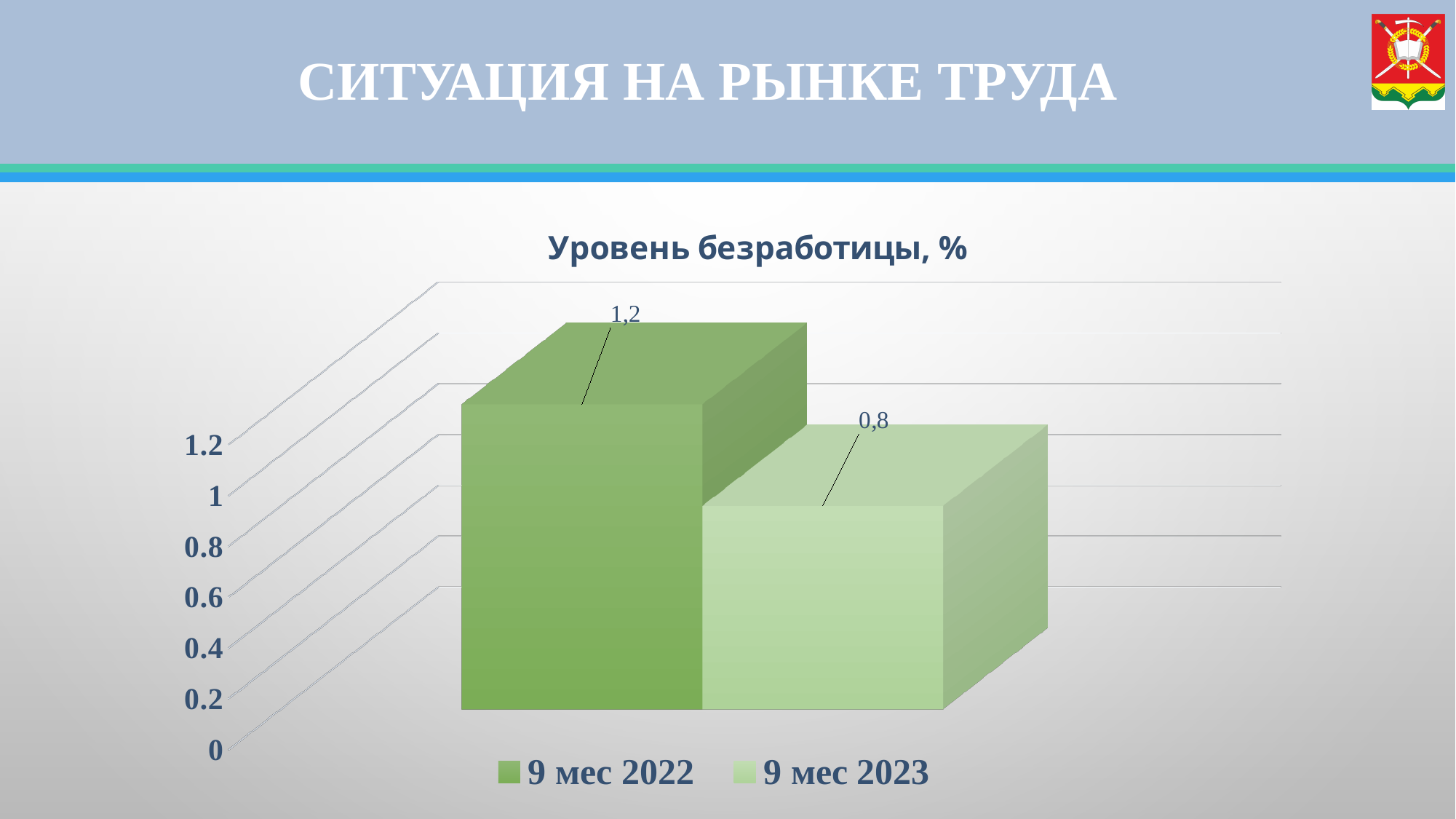
Which period has the higher unemployment rate? 9 мес 2022 Is the value for 9 мес 2023 greater or less than 1? less How many series does the legend list? 2 What is the unemployment rate for 9 мес 2022? 1,2 Did the unemployment rate rise or fall from 9 мес 2022 to 9 мес 2023? fall What is the title of the chart? Уровень безработицы, % Which period has the lower unemployment rate? 9 мес 2023 What is the unemployment rate for 9 мес 2023? 0,8 What kind of chart is shown on the slide? bar chart Is the unemployment rate for 9 мес 2022 larger or smaller than for 9 мес 2023? larger Is the value for 9 мес 2022 greater or less than 1? greater What is the difference between the unemployment rate for 9 мес 2022 and 9 мес 2023? 0,4